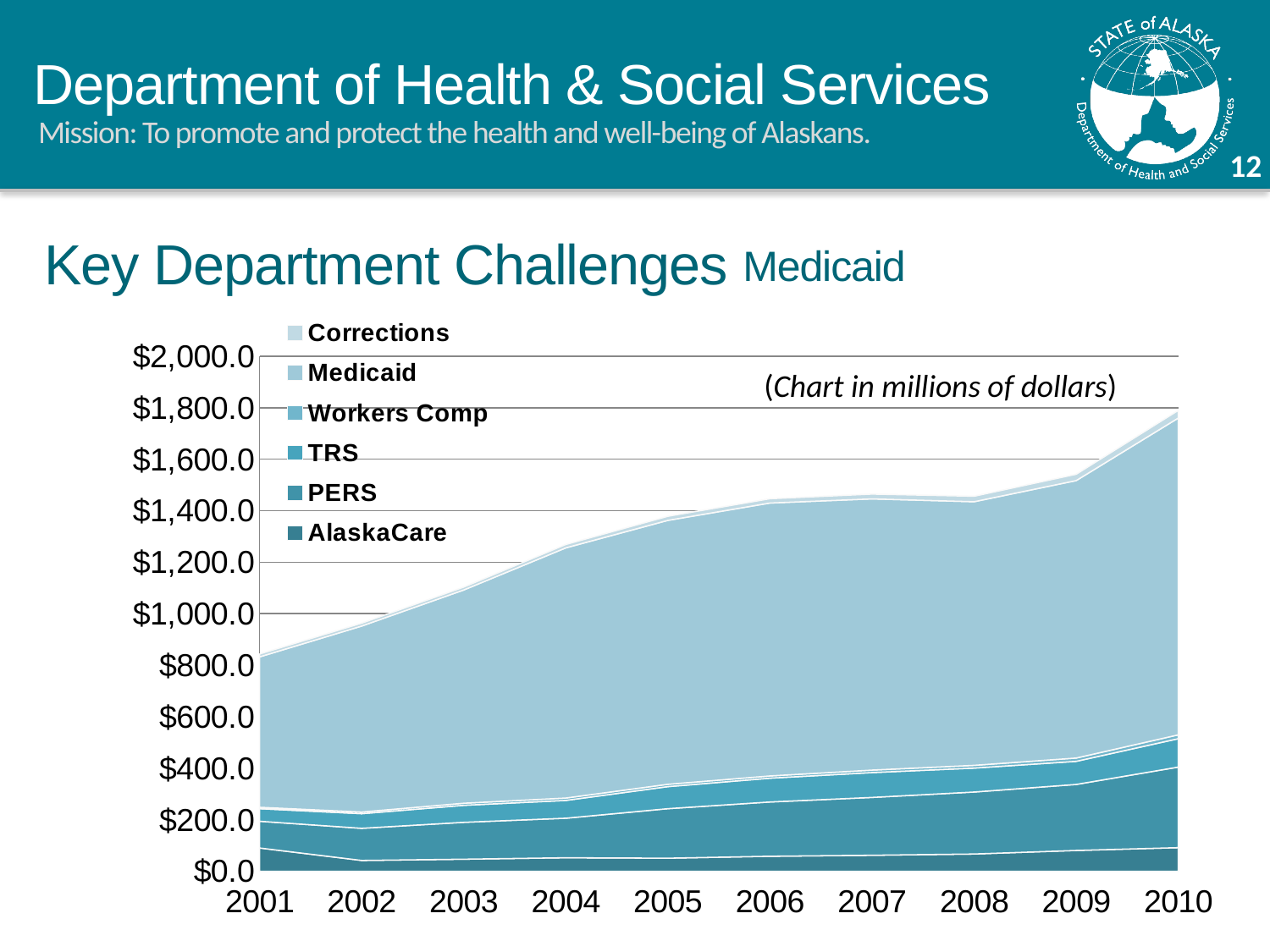
Which year has the highest total value? 2010 In what units are the chart values expressed? Millions of dollars How many years are shown along the x axis? 10 Which year has a larger total value, 2004 or 2009? 2009 Is the total value for 2010 greater or less than $1,600.0? greater Is the total value for 2008 greater or less than $1,200.0? greater Is the total value for 2002 greater or less than $1,000.0? less Which year has the lowest total value? 2001 Does the total value rise or fall from 2001 to 2010? Rise How many series does the legend list? 6 What kind of chart is shown on the slide? Stacked area chart